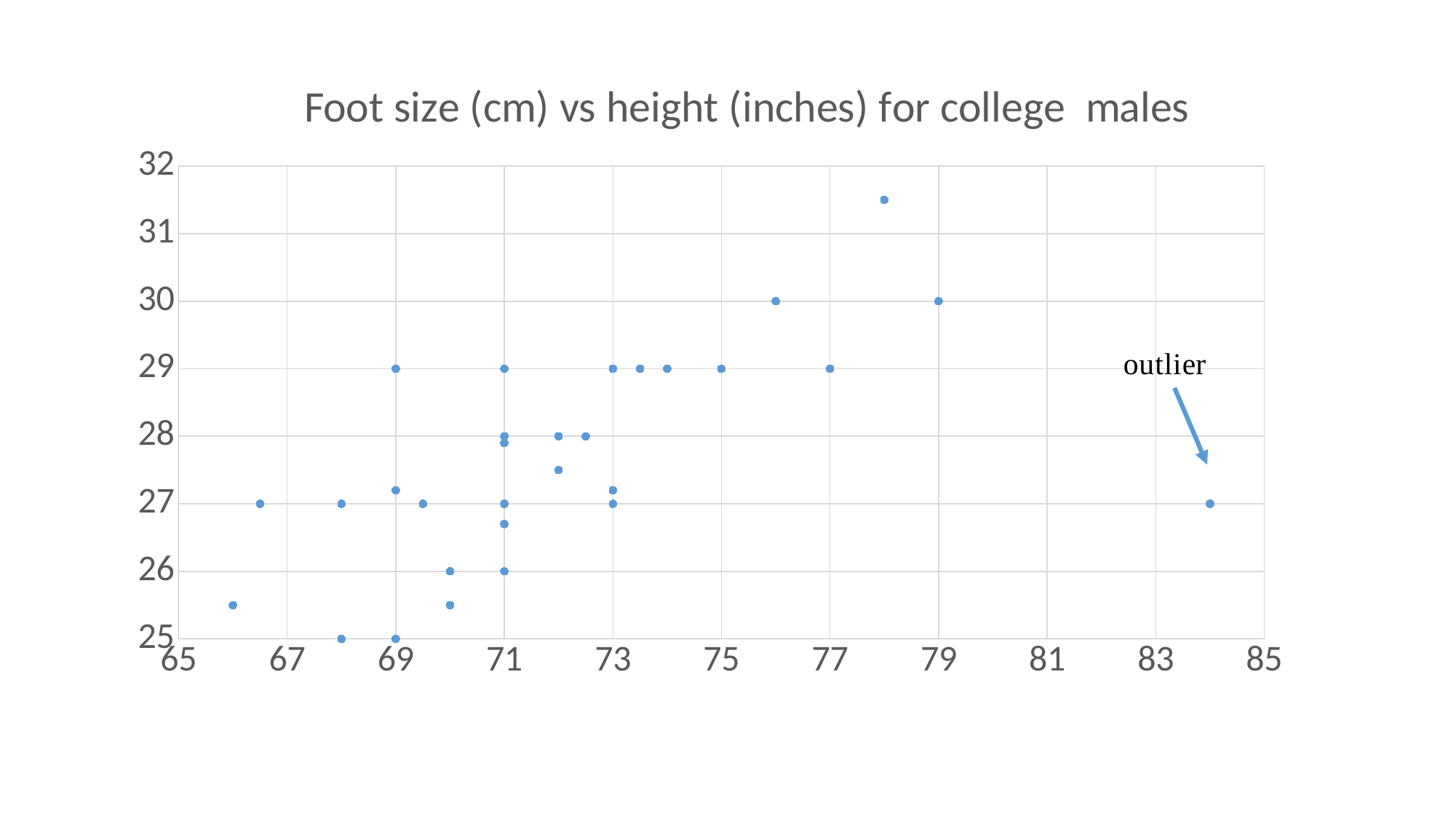
What is the foot size for the point at a height of 79 inches? 30 What is the title of the chart? Foot size (cm) vs height (inches) for college males Overall, does foot size tend to rise or fall as height increases along the x axis? rise What is the foot size for the point at a height of 75 inches? 29 What is the foot size for the point at a height of 77 inches? 29 Which has the larger foot size, the point at height 79 or the point at height 77? 79 Is the height of the point labelled outlier greater or less than 83? greater Is the foot size of the point labelled outlier greater or less than 28? less Is the largest foot size plotted greater or less than 31? greater What kind of chart is shown on the slide? scatter plot What label is attached to the point at the far right of the chart by the arrow? outlier What is the difference in foot size between the point at height 79 and the point at height 77? 1